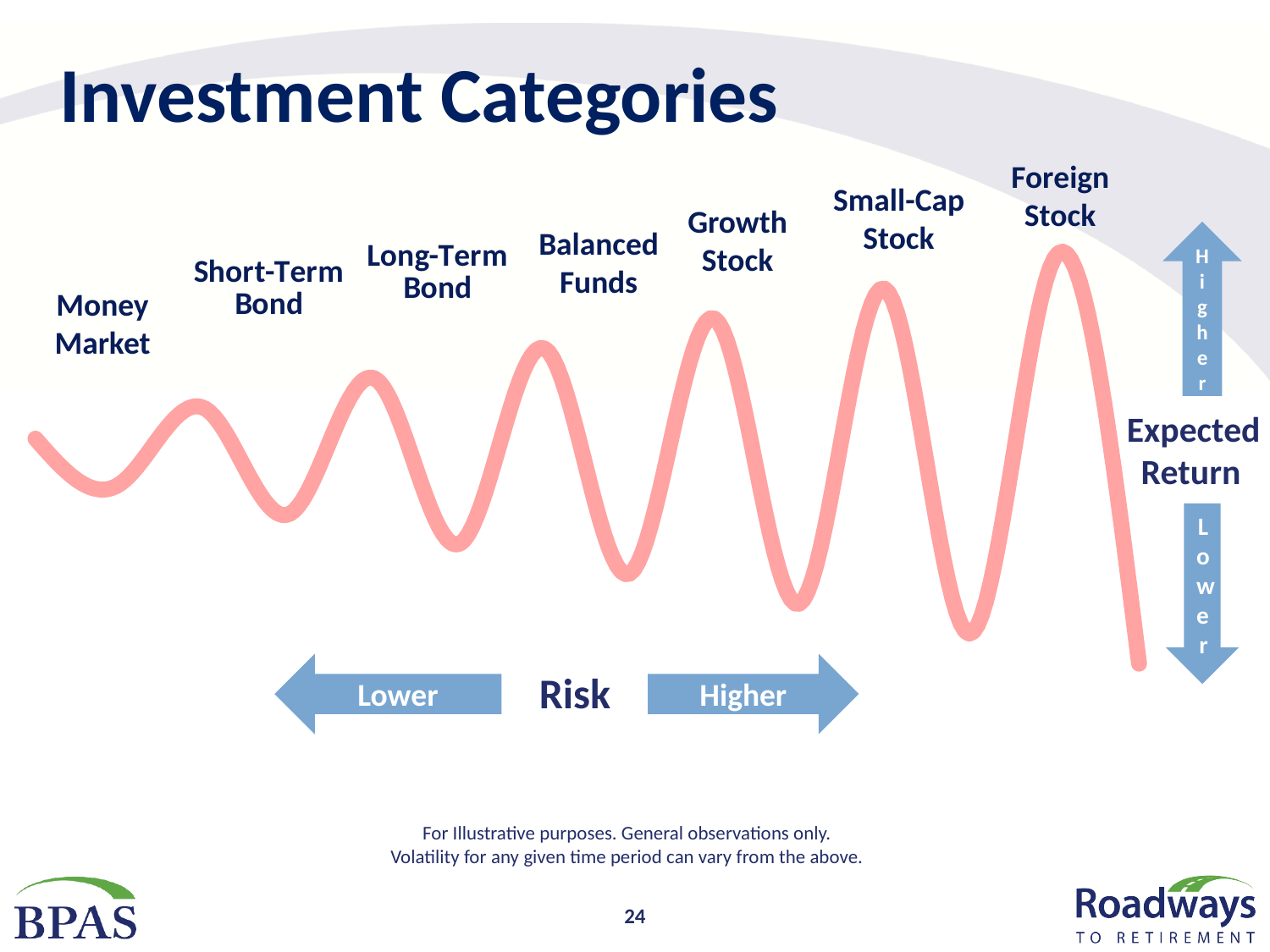
Which category is labelled immediately to the right of Balanced Funds? Growth Stock What kind of chart is shown on the slide? line chart What does the vertical axis of the chart represent? Expected Return How many investment categories are labelled along the chart? 7 Which category is shown with higher risk, Short-Term Bond or Small-Cap Stock? Small-Cap Stock Do the swings of the line get larger or smaller moving from left to right along the chart? larger What does the horizontal axis of the chart represent? Risk Which investment category is placed at the lowest-risk end of the chart? Money Market Which category is shown with lower expected return, Growth Stock or Long-Term Bond? Long-Term Bond Which investment category is placed at the highest-risk end of the chart? Foreign Stock